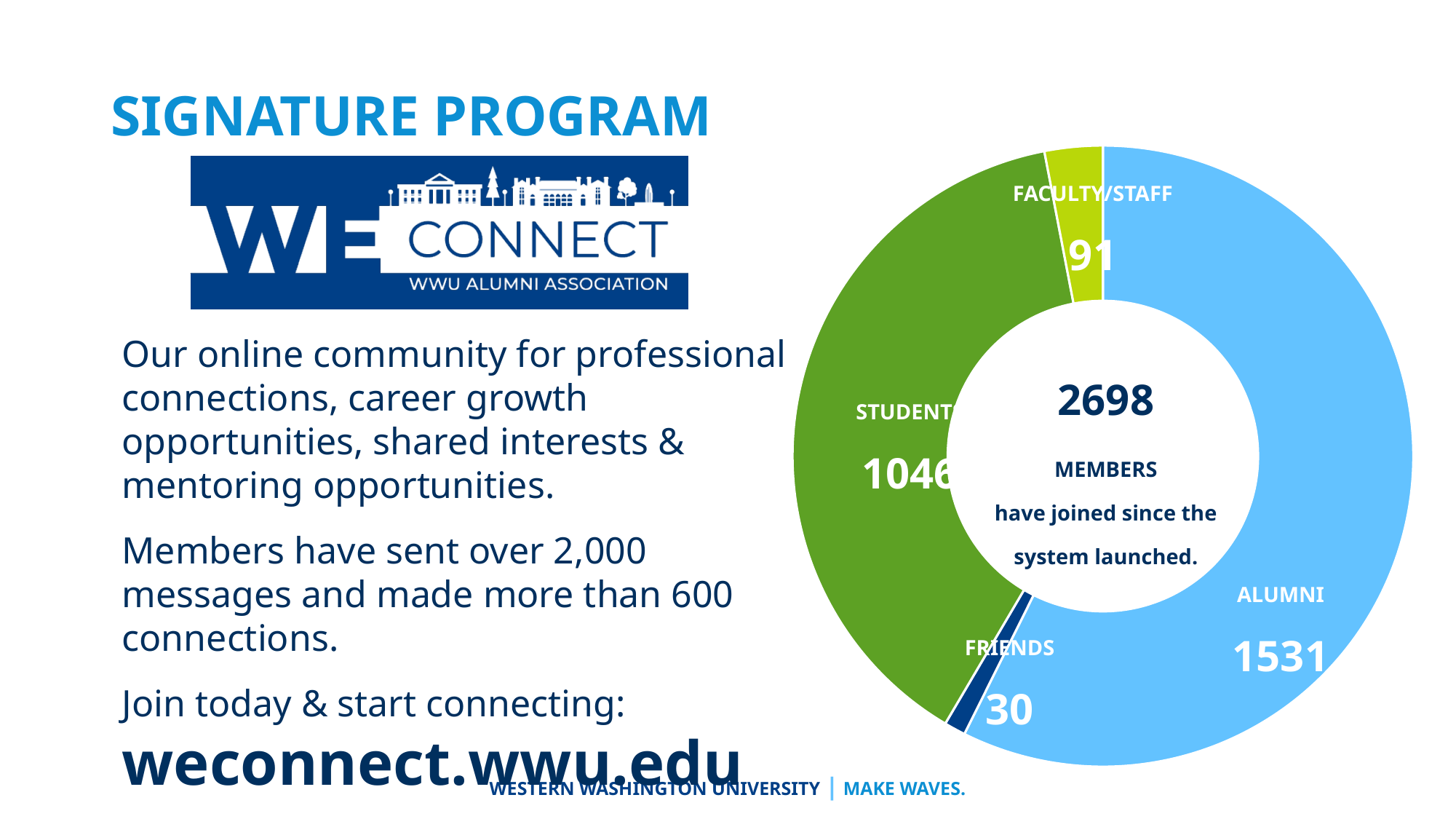
How many members are shown for Faculty/Staff? 91 Which is larger, the Students segment or the Faculty/Staff segment? Students What kind of chart is shown on the slide? pie chart (donut) Which category has the smallest segment in the chart? Friends Which category has the largest segment in the chart? Alumni What is the difference between the Alumni and Students values? 485 How many categories does the donut chart show? 4 What is the difference between the Faculty/Staff and Friends values? 61 What is the value shown for Students in the donut chart? 1046 What total number of members is shown in the center of the chart? 2698 How many members does the chart show for Alumni? 1531 What value is shown for the Friends segment? 30